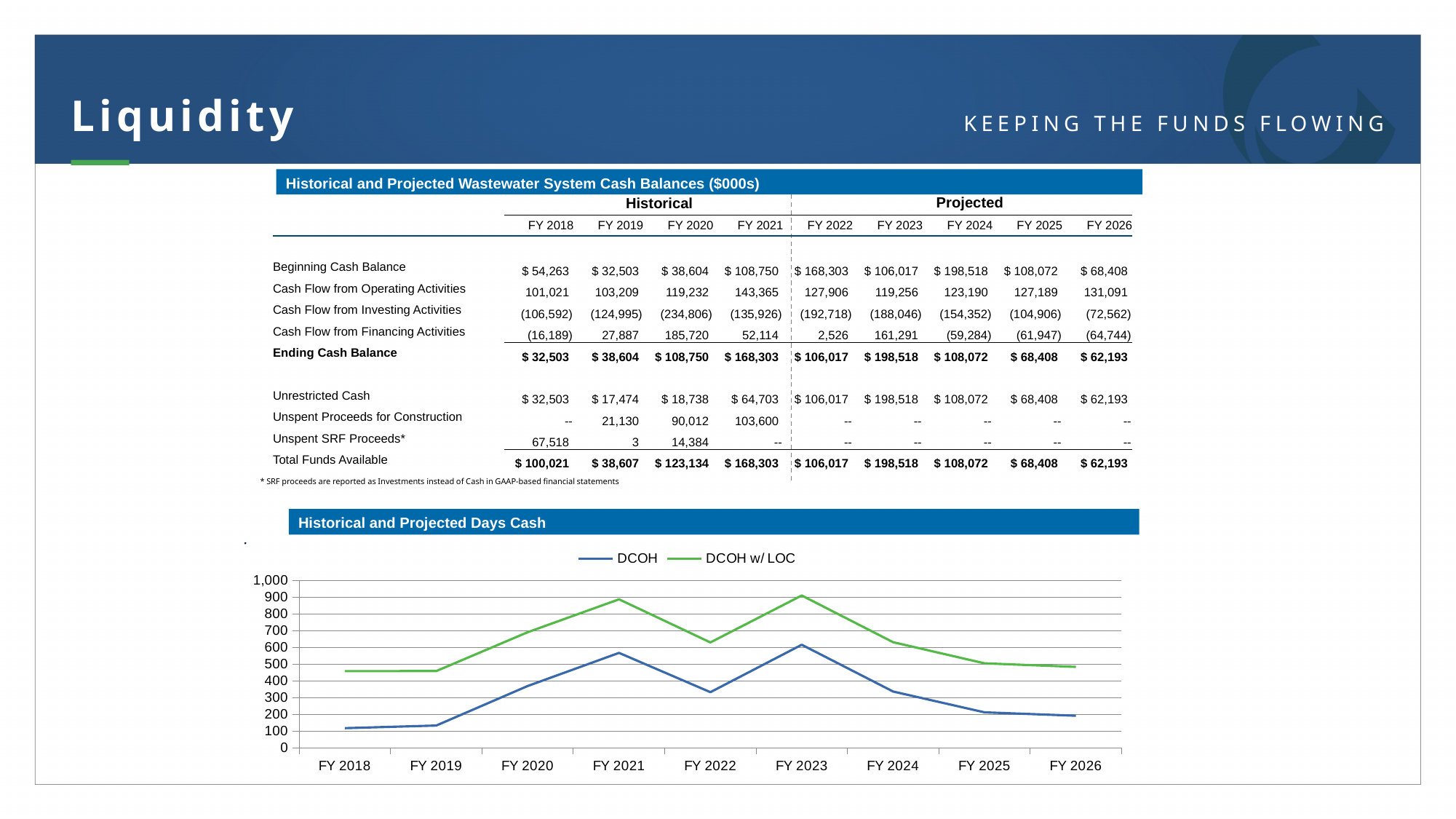
In the 'Historical and Projected Days Cash' chart, is the DCOH value for FY 2021 greater or less than 500? greater What are the two series named in the legend of the 'Historical and Projected Days Cash' chart? DCOH and DCOH w/ LOC In the 'Historical and Projected Days Cash' chart, which fiscal year has the highest DCOH value? FY 2023 In the 'Historical and Projected Days Cash' chart, is the DCOH w/ LOC value for FY 2021 greater or less than 800? greater In the 'Historical and Projected Days Cash' chart, which is larger: the DCOH w/ LOC value for FY 2020 or for FY 2024? FY 2020 What kind of chart is shown under the title 'Historical and Projected Days Cash'? line chart In the 'Historical and Projected Days Cash' chart, does the DCOH line rise or fall from FY 2023 to FY 2026? fall How many series does the legend of the 'Historical and Projected Days Cash' chart list? 2 In the 'Historical and Projected Days Cash' chart, is the DCOH w/ LOC value for FY 2026 greater or less than 600? less How many fiscal years are plotted on the x axis of the 'Historical and Projected Days Cash' chart? 9 In the 'Historical and Projected Days Cash' chart, which is larger: the DCOH value for FY 2021 or for FY 2022? FY 2021